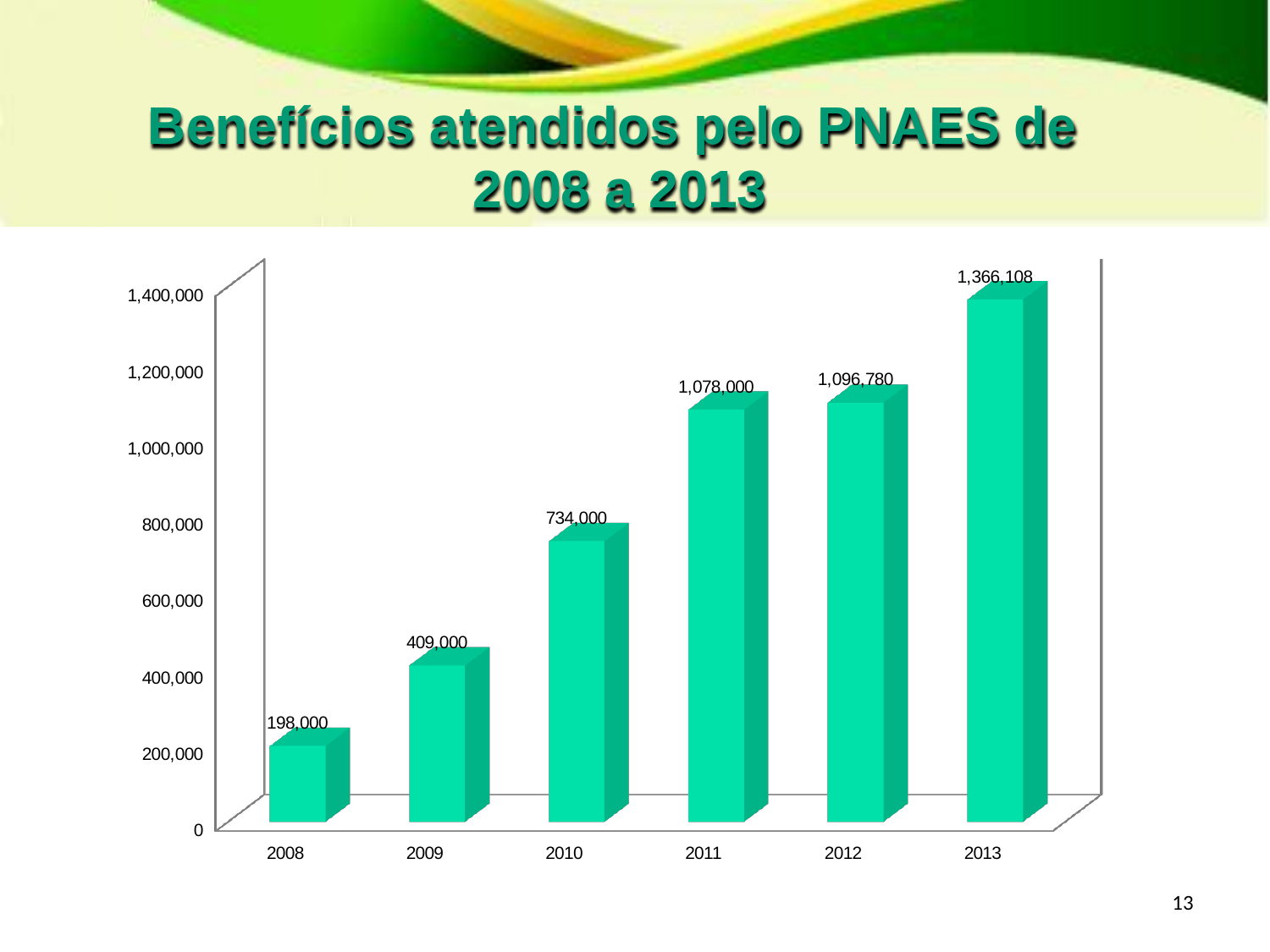
What is the value for 2010? 734,000 What is the value for 2008? 198,000 What is the difference between the values for 2009 and 2008? 211,000 Do the values rise or fall from 2008 to 2013? rise What kind of chart is shown on the slide? bar chart How many years are shown on the x axis? 6 Which is larger, the value for 2010 or the value for 2011? 2011 Is the value for 2010 greater or less than 800,000? less Which year has the highest value? 2013 What is the difference between the values for 2013 and 2012? 269,328 What is the value for 2012? 1,096,780 Which year has the lowest value? 2008